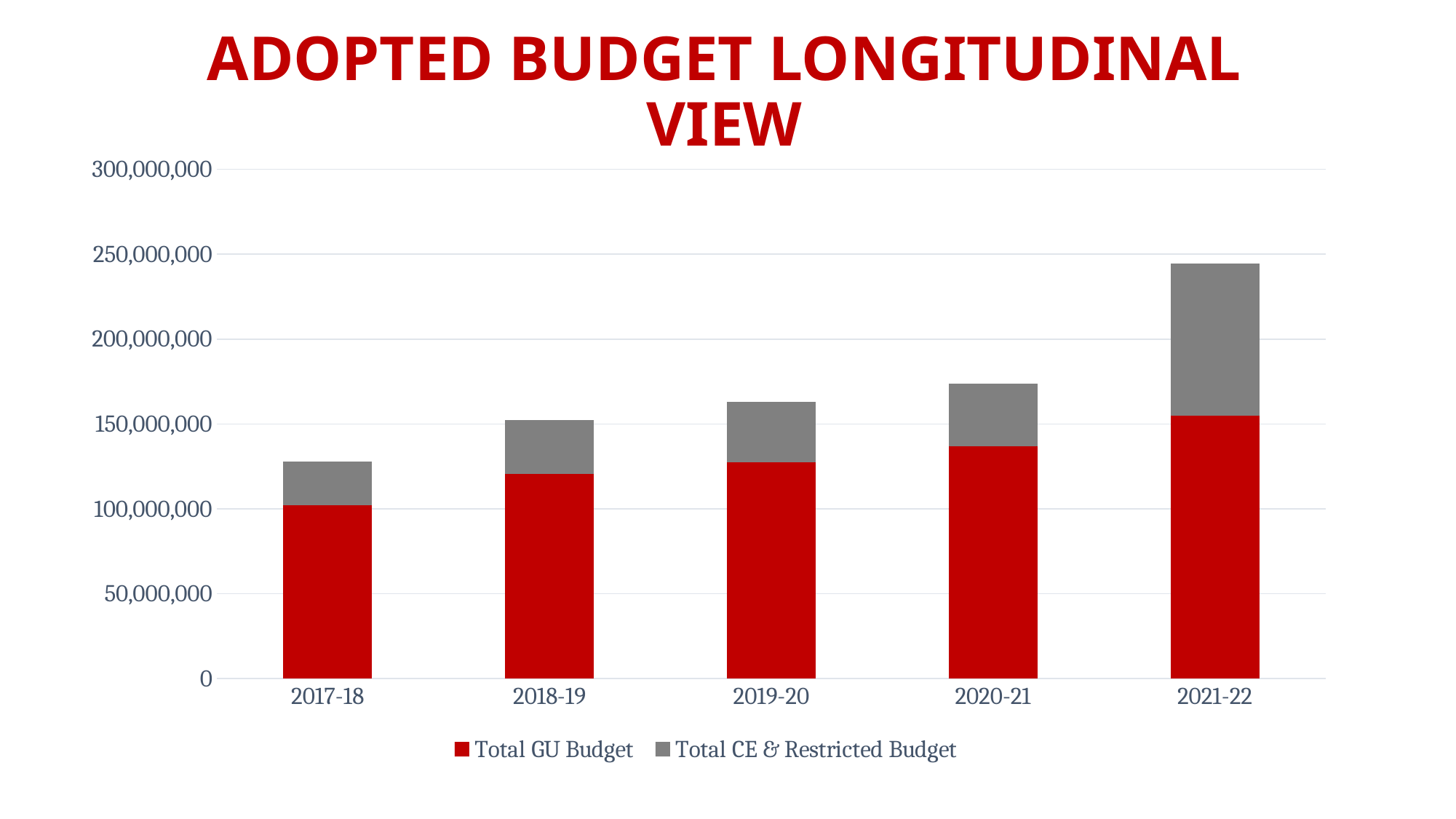
Which is larger, the Total CE & Restricted Budget segment for 2021-22 or for 2017-18? 2021-22 Is the total stacked bar for 2019-20 greater or less than 150,000,000? greater Is the total stacked bar for 2017-18 greater or less than 150,000,000? less Is the Total GU Budget for 2020-21 greater or less than 150,000,000? less Which year has the tallest stacked bar (highest total adopted budget)? 2021-22 How many series does the legend list? 2 What kind of chart is shown on the slide? stacked bar chart How many fiscal years are shown on the x axis? 5 Which colour represents Total GU Budget in the legend? red Which year has the shortest stacked bar (lowest total adopted budget)? 2017-18 Do the total stacked bars rise or fall from 2017-18 to 2021-22? rise